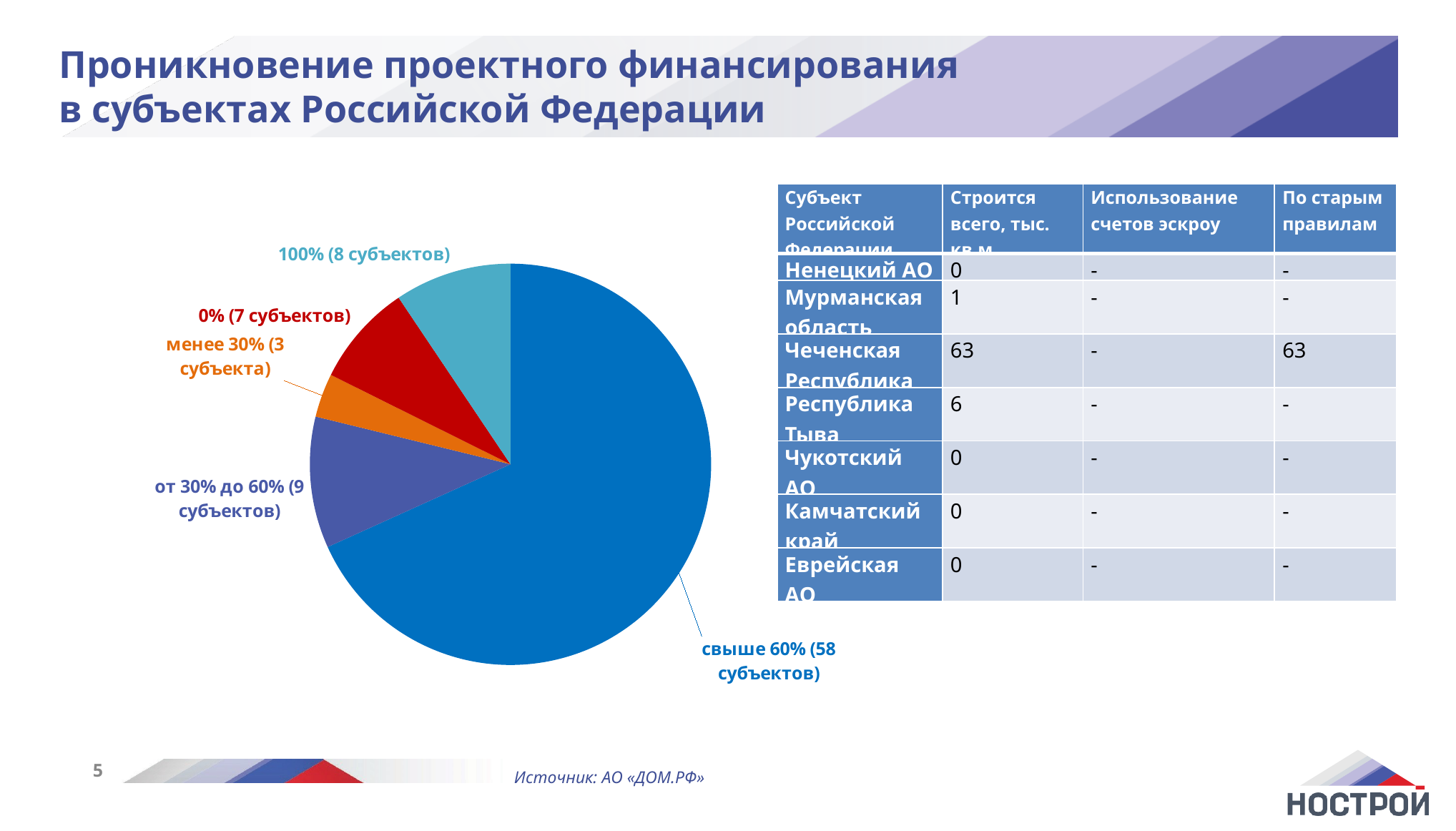
How many slices does the pie chart have? 5 How many subjects are in the '0%' slice of the pie chart? 7 субъектов What type of chart is shown on the left of the slide? Pie chart Which slice of the pie chart represents the smallest number of subjects? менее 30% How many subjects are in the 'от 30% до 60%' slice of the pie chart? 9 субъектов Which slice has more subjects: '100%' or '0%'? 100% What is the total number of subjects represented across all slices of the pie chart? 85 How many subjects are in the '100%' slice of the pie chart? 8 субъектов How many subjects are in the 'свыше 60%' slice of the pie chart? 58 субъектов Which slice of the pie chart represents the largest number of subjects? свыше 60% How many subjects are in the 'менее 30%' slice of the pie chart? 3 субъекта What is the difference in the number of subjects between the 'свыше 60%' slice and the 'от 30% до 60%' slice? 49